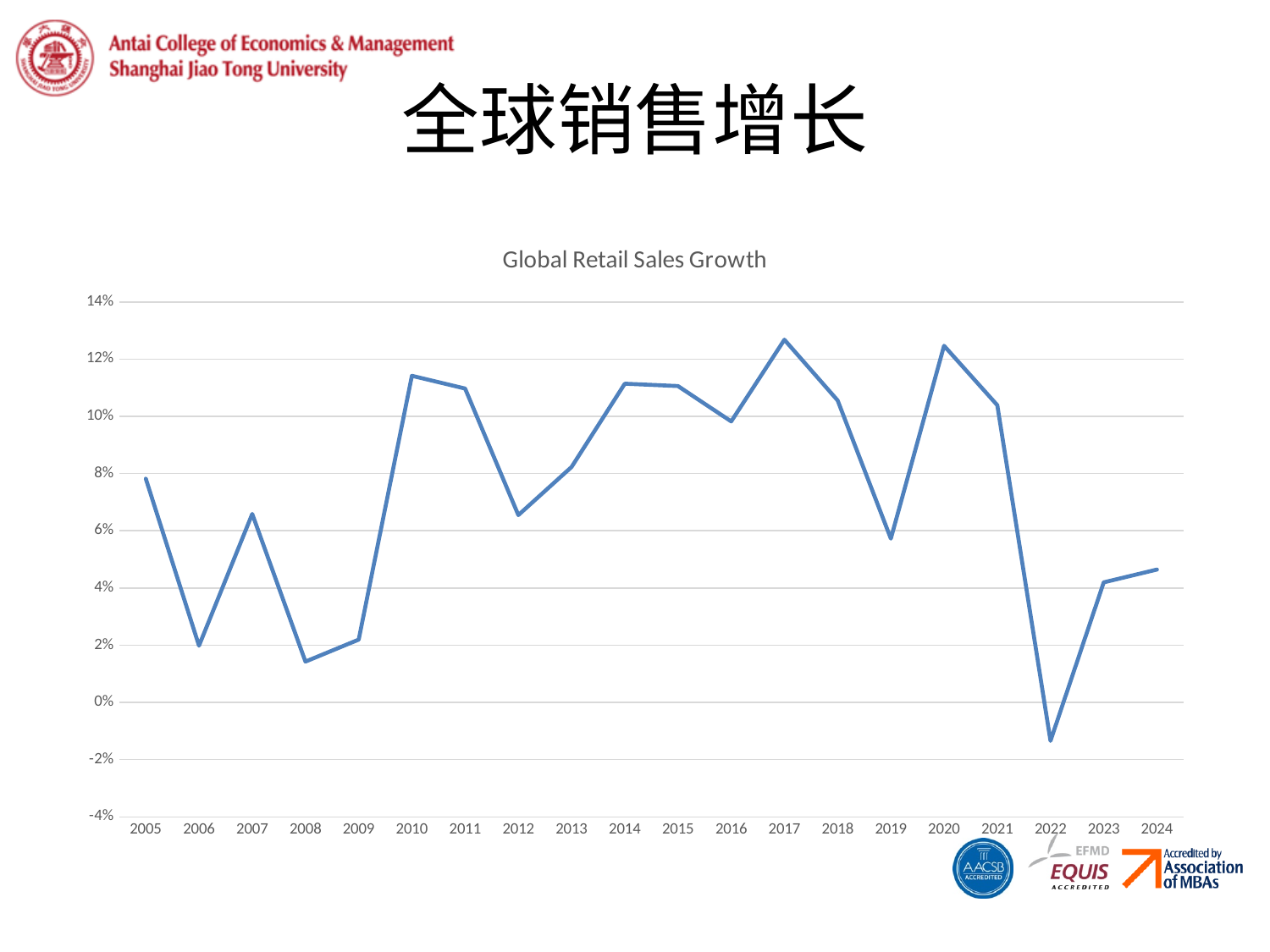
What kind of chart is shown on the slide? line chart Is the value for 2010 greater or less than 10%? greater Is the value for 2022 greater or less than 0%? less Is the value for 2019 greater or less than 6%? less Does the value rise or fall from 2022 to 2024? rise Which year has the higher value, 2013 or 2014? 2014 Which year has the lowest global retail sales growth? 2022 What is the title of the chart? Global Retail Sales Growth Which year has the higher value, 2018 or 2019? 2018 How many years are plotted on the x axis of the chart? 20